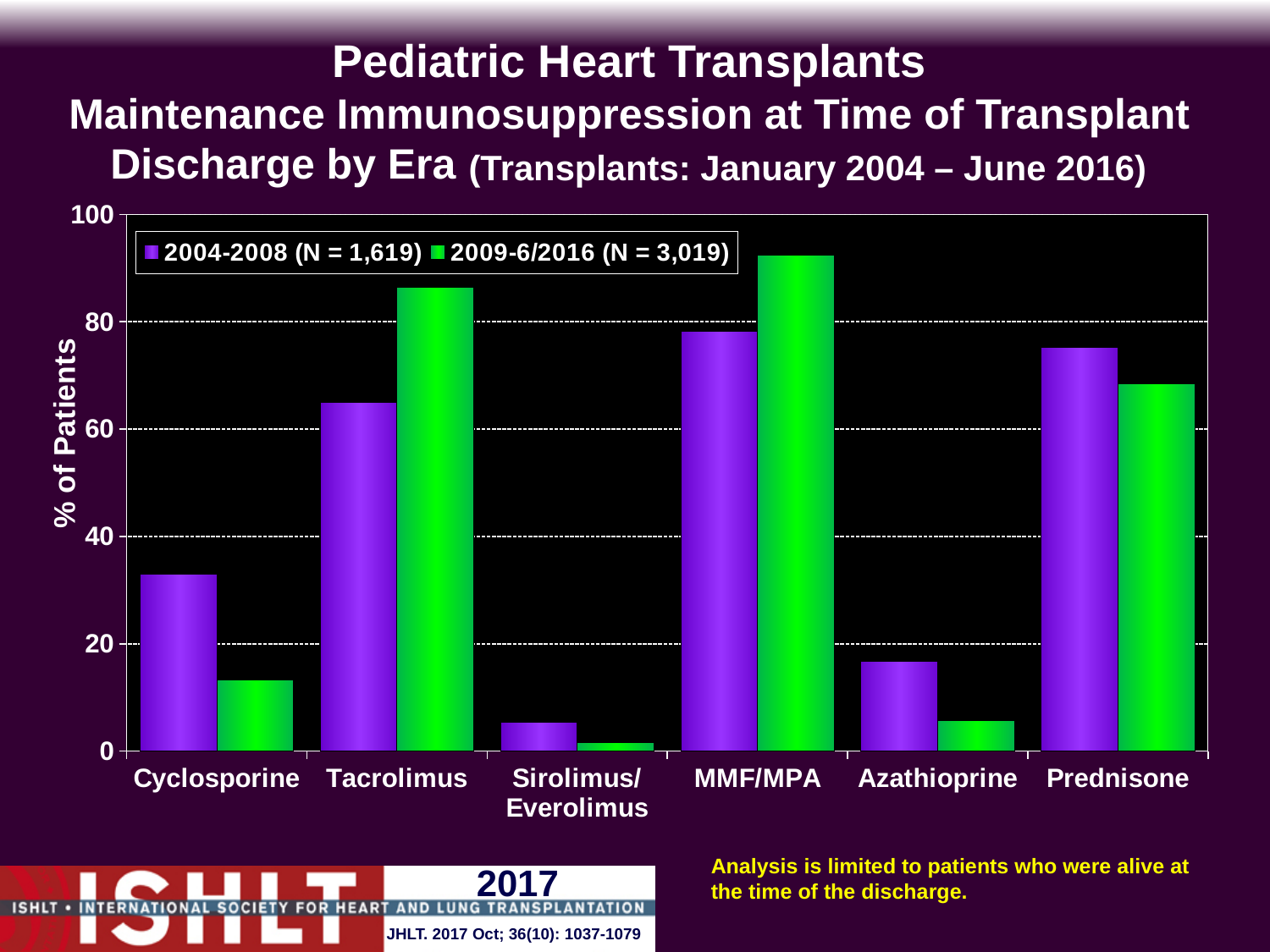
Which category has the lowest value for the 2004-2008 series? Sirolimus/Everolimus Is the value for Azathioprine in the 2009-6/2016 series greater or less than 20? less Is the value for MMF/MPA in the 2004-2008 series greater or less than 60? greater How many series does the legend list? 2 Which category has the highest value for the 2009-6/2016 series? MMF/MPA For Prednisone, which series has the larger value, 2004-2008 or 2009-6/2016? 2004-2008 Is the value for Tacrolimus in the 2009-6/2016 series greater or less than 80? greater For Tacrolimus, which series has the larger value, 2004-2008 or 2009-6/2016? 2009-6/2016 What kind of chart is shown on the slide? bar chart How many drug categories are shown on the x axis? 6 What is the label of the y axis? % of Patients